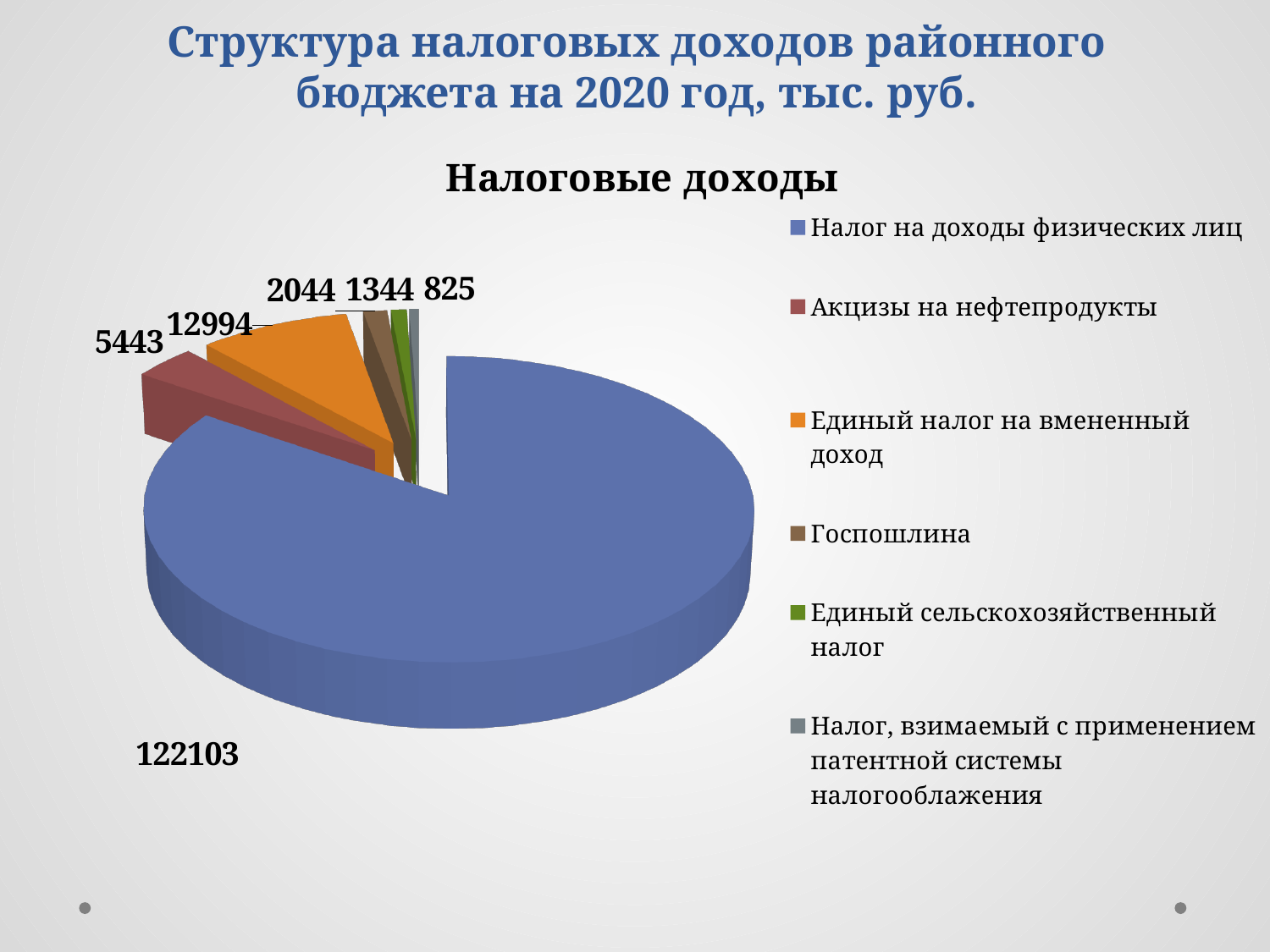
Which category has the smallest slice of the pie? Налог, взимаемый с применением патентной системы налогооблажения What is the title of the chart? Налоговые доходы What is the difference between Единый налог на вмененный доход and Акцизы на нефтепродукты? 7551 What is the value for Госпошлина? 2044 What is the value for Налог, взимаемый с применением патентной системы налогооблажения? 825 Which is larger, Госпошлина or Единый сельскохозяйственный налог? Госпошлина Which category has the largest slice of the pie? Налог на доходы физических лиц What is the value for Акцизы на нефтепродукты? 5443 What is the value for Налог на доходы физических лиц? 122103 What type of chart is shown on the slide? pie chart How many categories does the legend list? 6 What is the value for Единый налог на вмененный доход? 12994